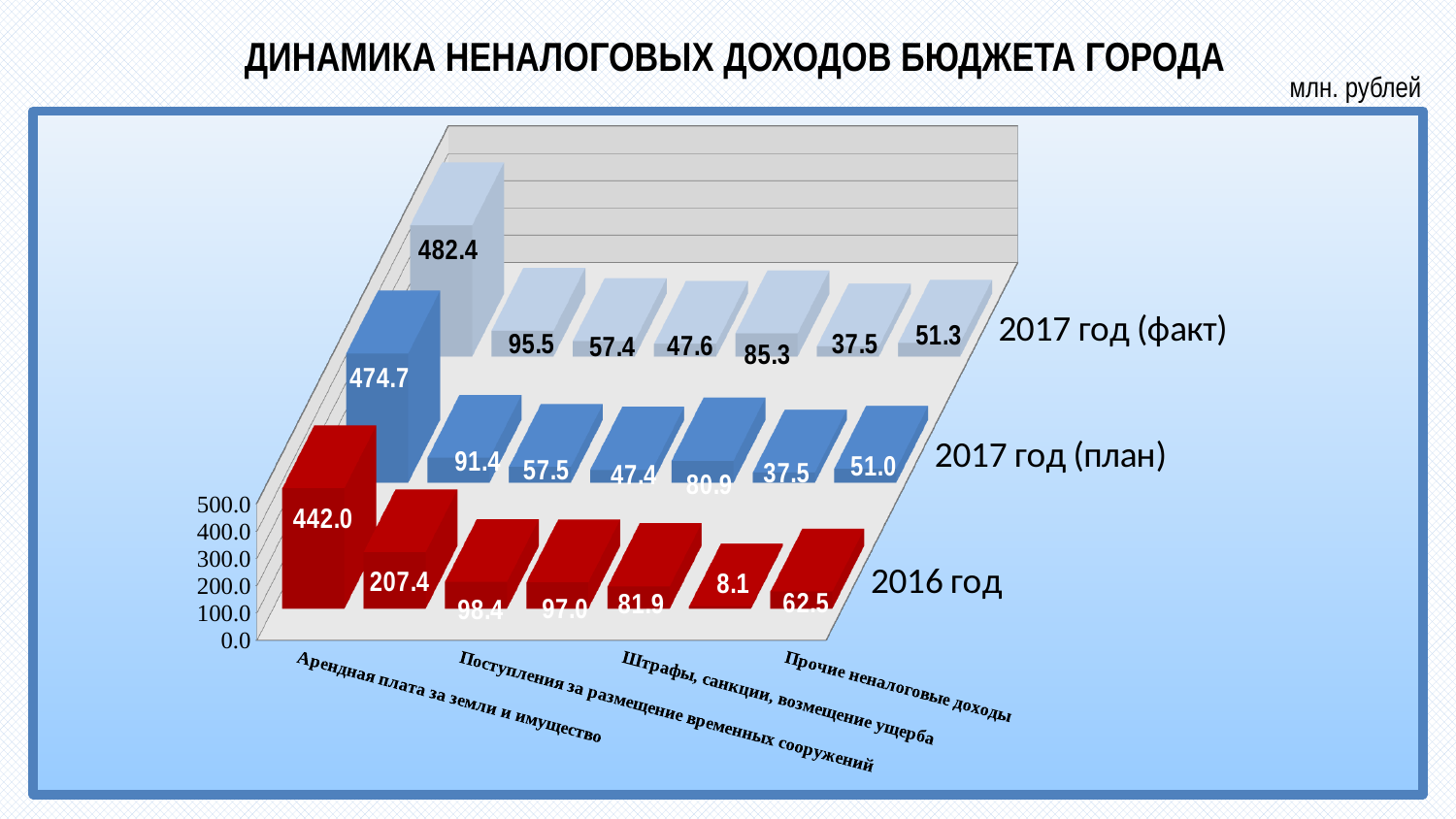
What kind of chart is shown on the slide? bar chart What is the value for Арендная плата за земли и имущество in 2017 год (факт)? 482.4 What is the value for Прочие неналоговые доходы in 2017 год (факт)? 51.3 Which is larger for Прочие неналоговые доходы: the 2016 год value or the 2017 год (факт) value? 2016 год How many bars are plotted in each series? 7 What is the lowest value shown in the 2016 год series? 8.1 In what units are the values on the chart expressed? млн. рублей How many data series (years) does the chart show? 3 Which category has the highest value in the 2016 год series? Арендная плата за земли и имущество What is the value for Арендная плата за земли и имущество in 2016 год? 442.0 What is the value for Арендная плата за земли и имущество in 2017 год (план)? 474.7 What is the difference between the 2017 год (факт) and 2017 год (план) values for Арендная плата за земли и имущество? 7.7